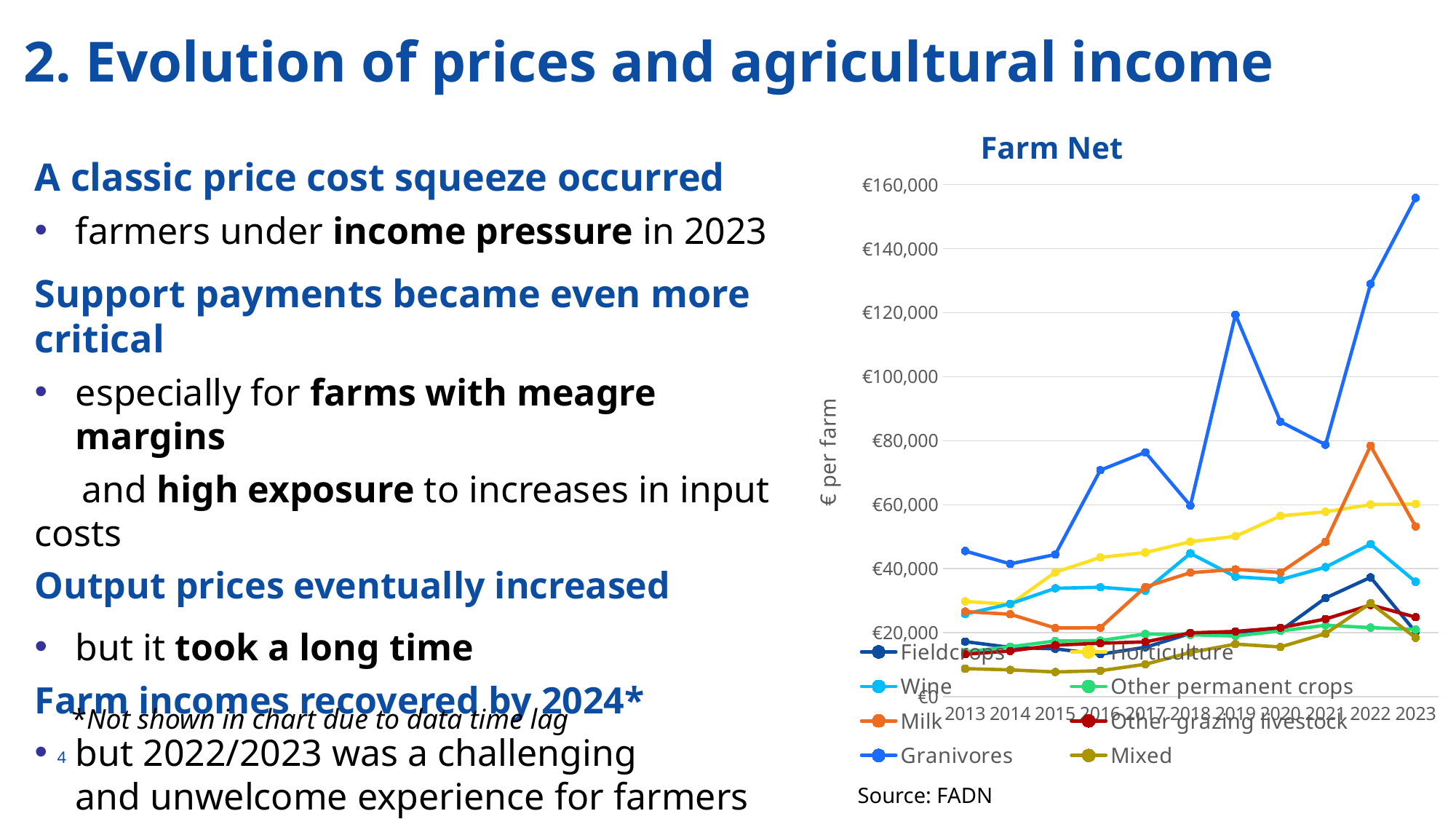
Is the value for Granivores in 2020 greater or less than €80,000? greater How many series does the legend of the Farm Net chart list? 8 Which series has the highest value in 2023 in the Farm Net chart? Granivores Is the value for Mixed in 2013 greater or less than €20,000? less What is the y-axis label of the Farm Net chart? € per farm In 2022, which is larger in the Farm Net chart: Granivores or Milk? Granivores Is the value for Granivores in 2023 greater or less than €140,000? greater How many years are shown on the x axis of the Farm Net chart? 11 What kind of chart is the Farm Net chart? line chart Does the Horticulture series generally rise or fall from 2013 to 2023? rise Which series has the lowest value in 2013 in the Farm Net chart? Mixed